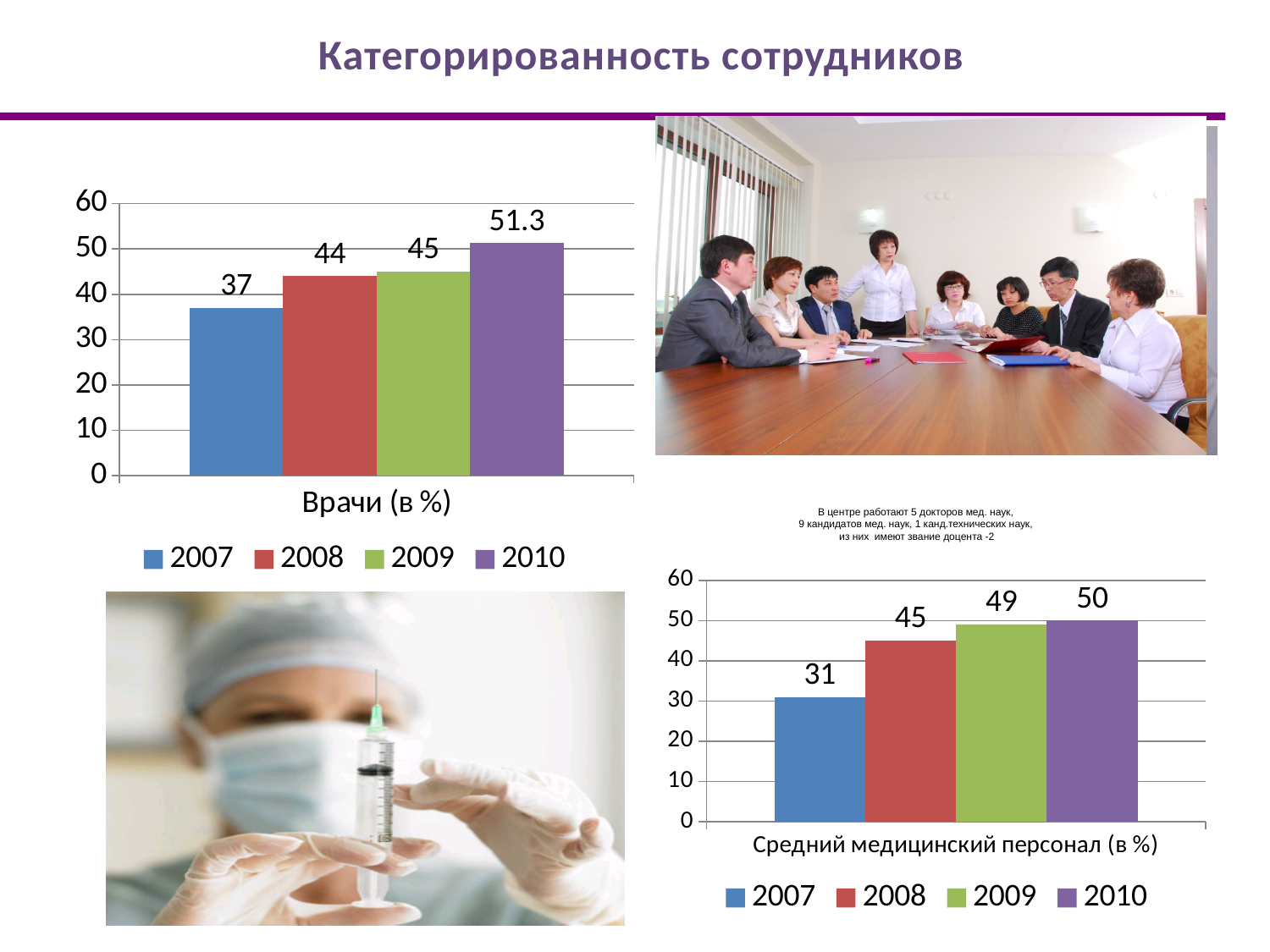
In the chart 'Врачи (в %)', how many series does the legend list? 4 In the chart 'Средний медицинский персонал (в %)', which is larger, the value for 2009 or the value for 2010? 2010 In the chart 'Врачи (в %)', which year has the highest value? 2010 In the chart 'Врачи (в %)', what is the value for 2007? 37 In the chart 'Врачи (в %)', what is the value for 2010? 51.3 In the chart 'Врачи (в %)', do the values rise or fall from 2007 to 2010? rise In the chart 'Средний медицинский персонал (в %)', what is the difference between the 2009 and 2007 values? 18 In the chart 'Врачи (в %)', what colour is the bar for 2009? green In the chart 'Средний медицинский персонал (в %)', which year has the lowest value? 2007 What kind of chart is 'Средний медицинский персонал (в %)'? bar chart In the chart 'Врачи (в %)', what is the difference between the 2010 and 2007 values? 14.3 In the chart 'Средний медицинский персонал (в %)', what is the value for 2008? 45